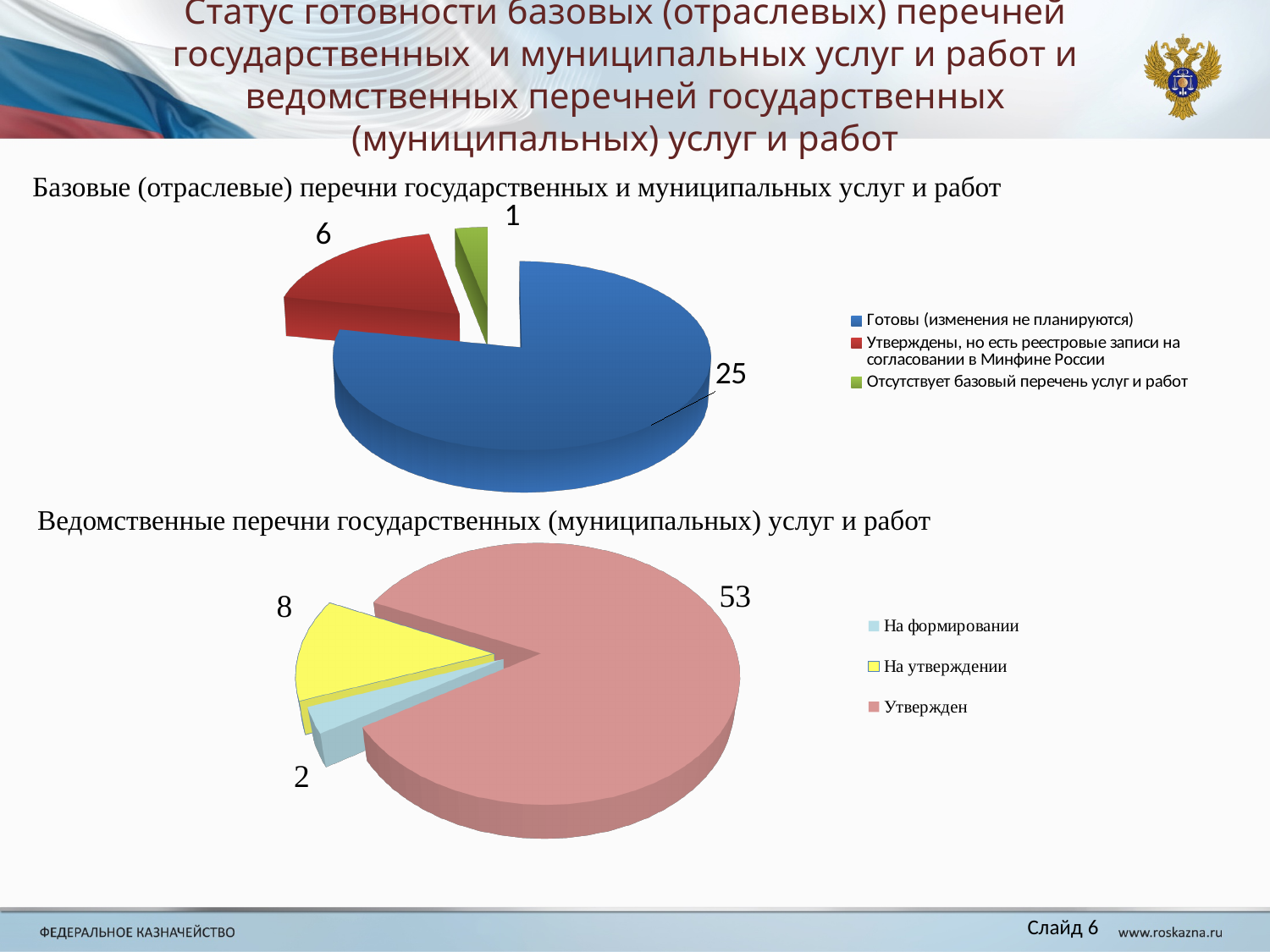
In the bottom chart (Ведомственные перечни), which category has the smallest slice? На формировании In the bottom chart (Ведомственные перечни), what is the value for 'На утверждении'? 8 In the bottom chart (Ведомственные перечни), what is the total of all slices? 63 In the top chart (Базовые перечни), what is the value for 'Готовы (изменения не планируются)'? 25 In the top chart (Базовые перечни), what is the difference between the 'Готовы' value and the 'Утверждены, но есть реестровые записи на согласовании в Минфине России' value? 19 In the top chart (Базовые перечни), what is the total of all slices? 32 In the bottom chart (Ведомственные перечни), what colour is the 'Утвержден' slice? Pink In the bottom chart (Ведомственные перечни), which is larger: 'Утвержден' or 'На утверждении'? Утвержден In the top chart (Базовые перечни), what is the value for 'Отсутствует базовый перечень услуг и работ'? 1 What type of chart is used for the top chart, 'Базовые (отраслевые) перечни государственных и муниципальных услуг и работ'? Pie chart How many categories does the legend of the top chart (Базовые перечни) list? 3 In the top chart (Базовые перечни), which category has the largest slice? Готовы (изменения не планируются)